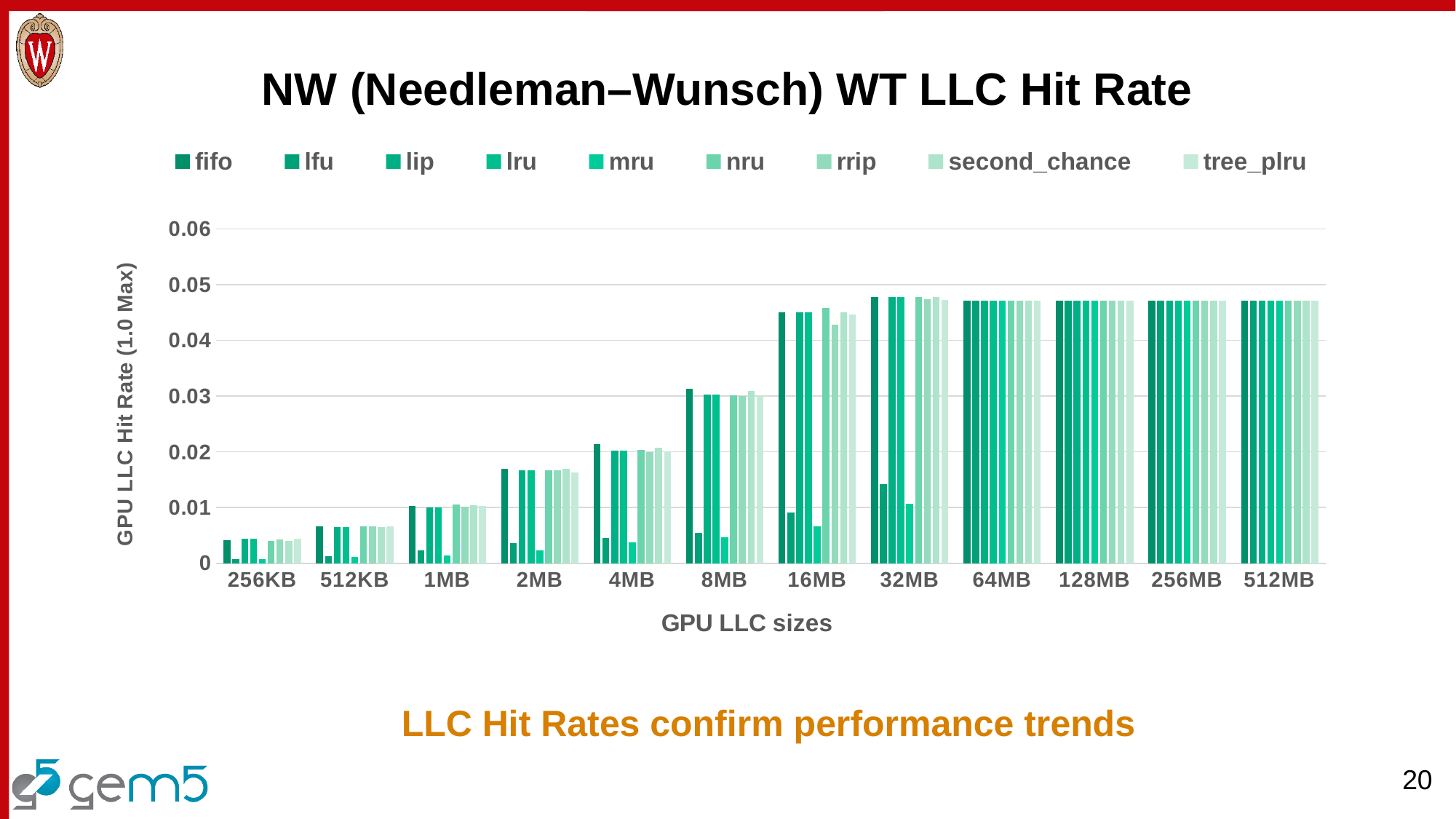
At 16MB, which is larger, the fifo value or the lfu value? fifo How many series does the legend list? 9 Is the lfu value for 32MB greater or less than 0.02? less What kind of chart is shown on the slide? bar chart What is the label of the y axis? GPU LLC Hit Rate (1.0 Max) How many GPU LLC size categories are shown on the x axis? 12 Is the lfu value for 256KB greater or less than 0.01? less Is the fifo value for 16MB greater or less than 0.04? greater What is the title of the chart? NW (Needleman–Wunsch) WT LLC Hit Rate Do the fifo values generally rise or fall as the GPU LLC size increases along the x axis? rise Which GPU LLC size has the lowest fifo value? 256KB